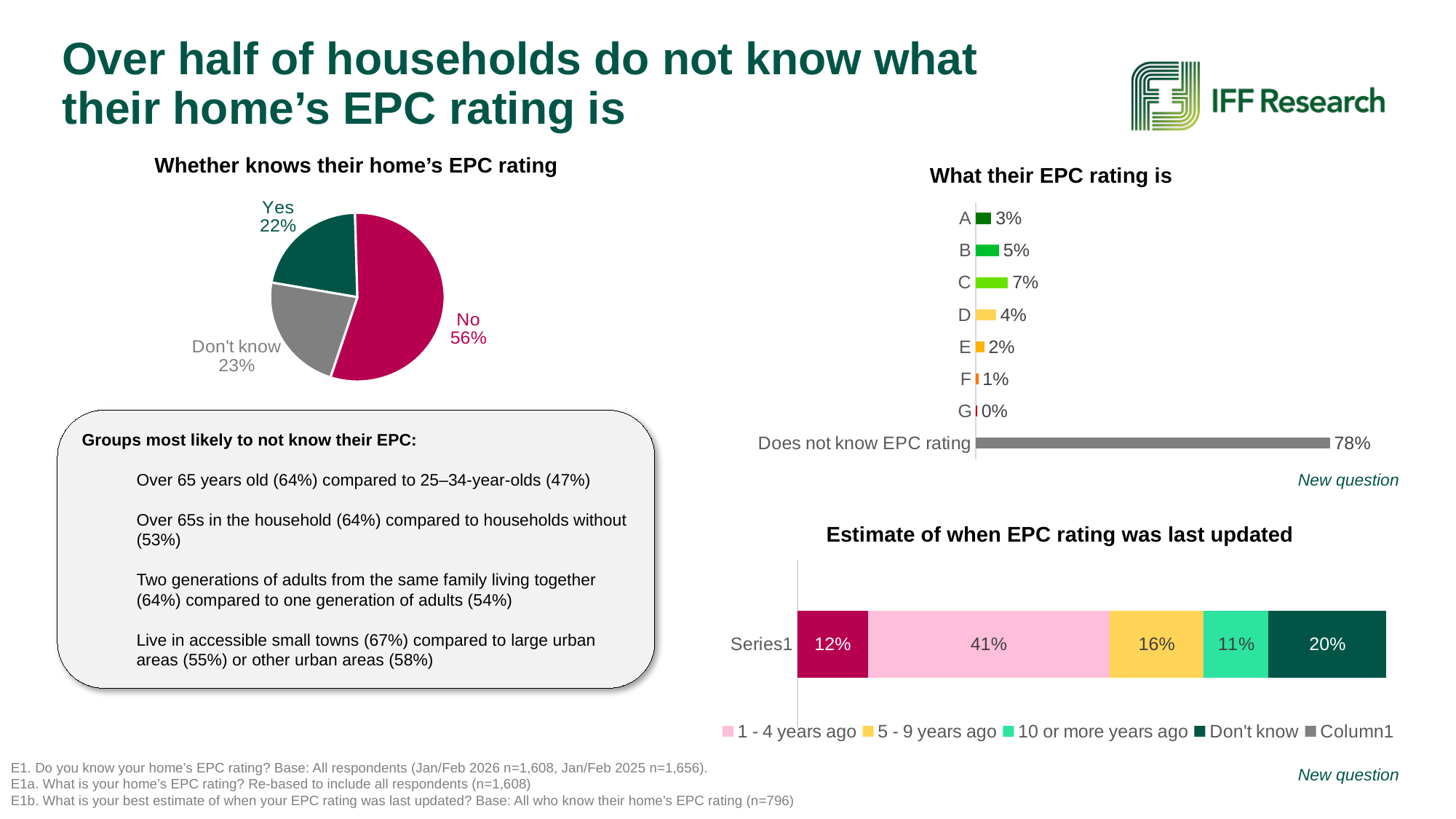
In the pie chart 'Whether knows their home's EPC rating', what percentage answered 'No'? 56% In the chart 'What their EPC rating is', what percentage does not know their EPC rating? 78% In the pie chart 'Whether knows their home's EPC rating', which response has the smallest share? Yes In the pie chart 'Whether knows their home's EPC rating', how many percentage points larger is 'No' than 'Yes'? 34 In the pie chart 'Whether knows their home's EPC rating', what percentage answered 'Don't know'? 23% In the chart 'Estimate of when EPC rating was last updated', what percentage is shown for '1 - 4 years ago'? 41% In the chart 'Estimate of when EPC rating was last updated', what percentage is shown for 'Don't know'? 20% In the chart 'What their EPC rating is', how many categories are shown? 8 What type of chart is 'Estimate of when EPC rating was last updated'? Stacked bar chart In the chart 'What their EPC rating is', which of the lettered ratings A to G has the highest percentage? C In the chart 'What their EPC rating is', is the value for B larger or smaller than the value for D? larger In the chart 'What their EPC rating is', what percentage have a rating of C? 7%